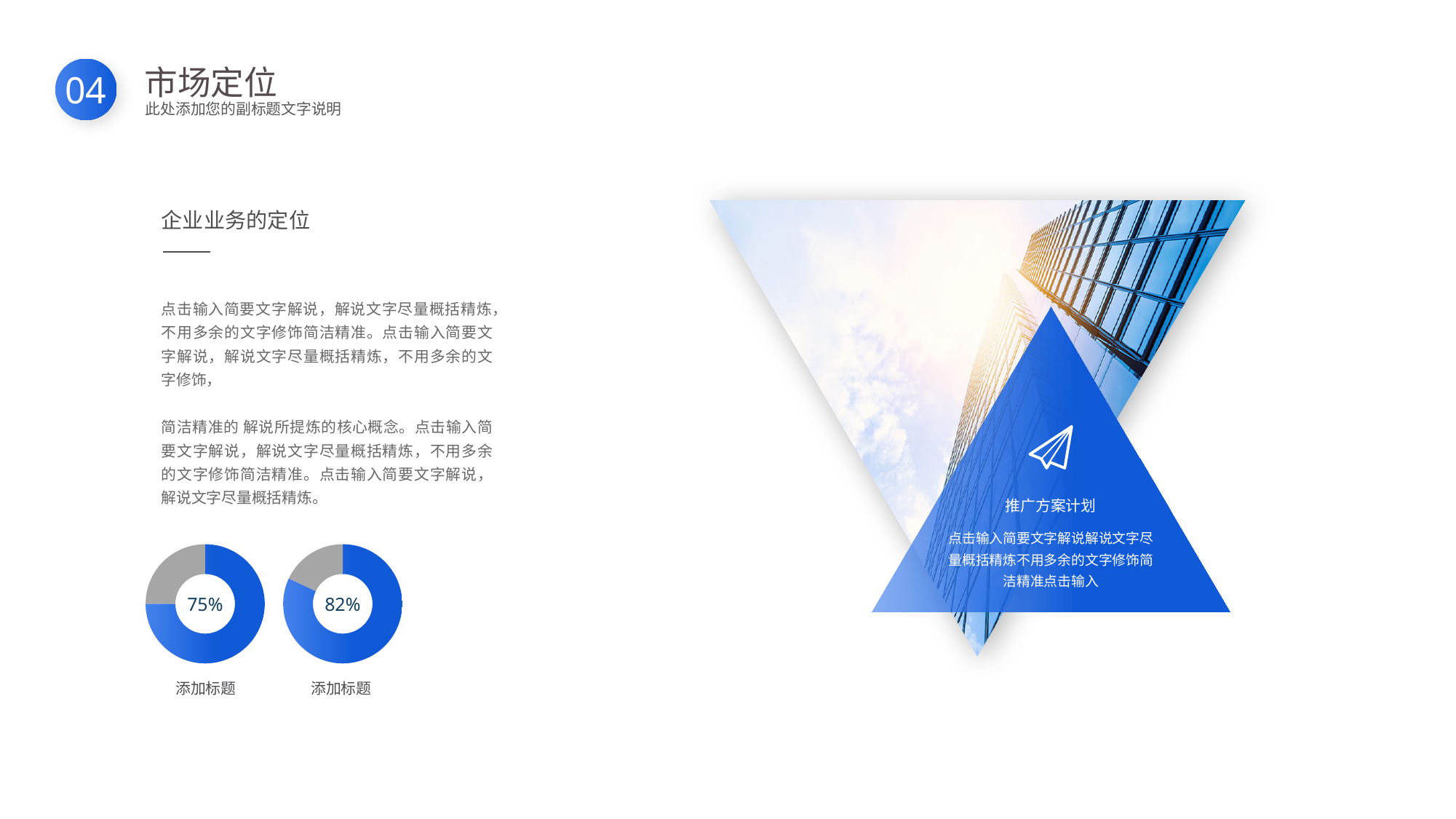
What value is shown in the centre of the left donut chart? 75% What share of the left donut chart is the grey (unfilled) portion? 25% What label appears beneath each of the two donut charts? 添加标题 What share of the right donut chart is the grey (unfilled) portion? 18% What value is shown in the centre of the right donut chart? 82% Which donut chart shows the larger percentage, the left one or the right one? The right one What colour is the filled (highlighted) portion of the donut charts? Blue How many donut charts are on the slide? 2 What kind of charts are the two small charts at the bottom left of the slide? Donut (pie) charts What is the difference between the percentage in the right donut chart and the percentage in the left donut chart? 7 percentage points Is the value shown in the left donut chart greater or less than 50%? greater